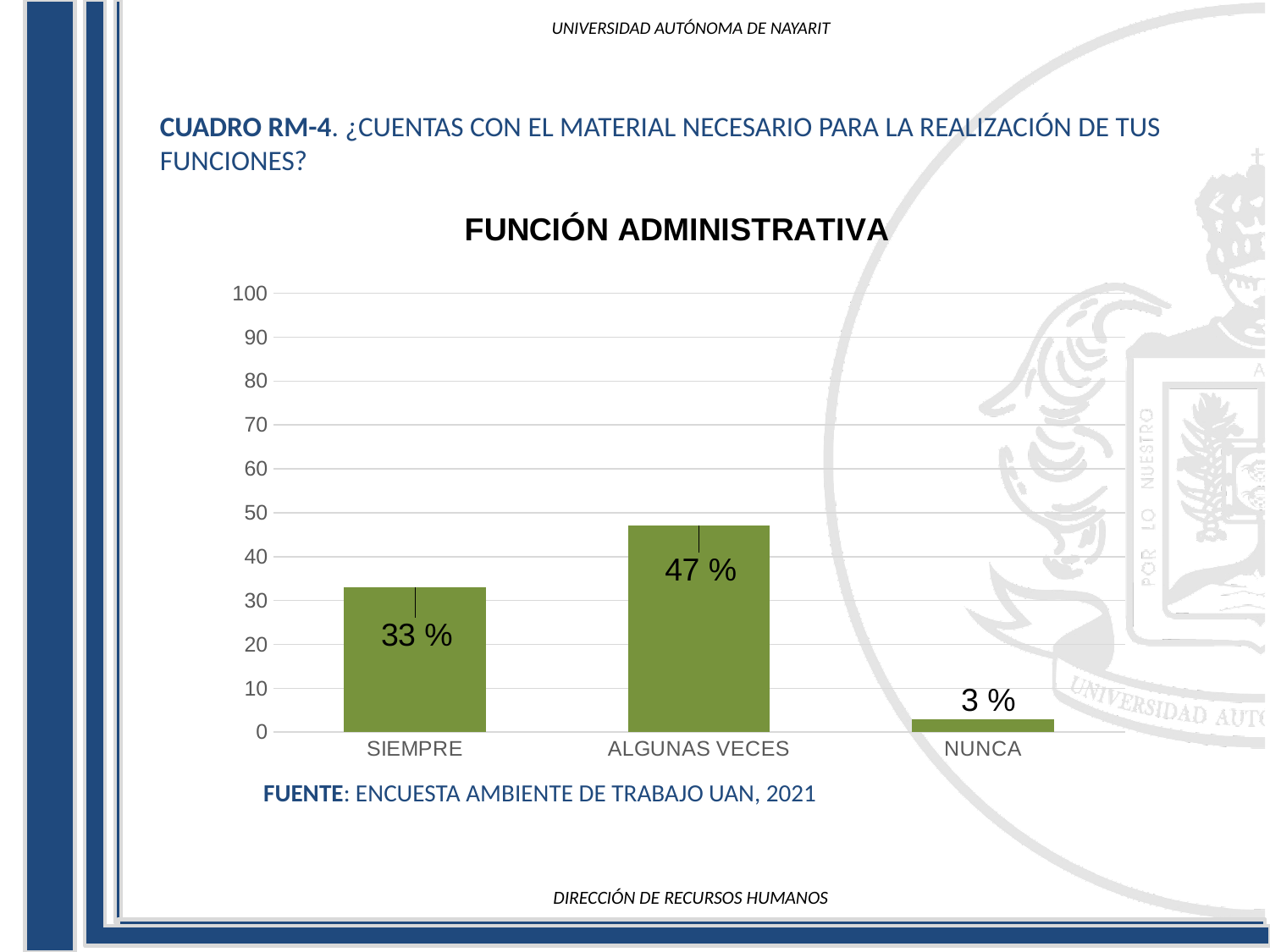
What is the value for NUNCA? 3 % Is the value for ALGUNAS VECES greater or less than 40? greater Which category has the highest value? ALGUNAS VECES Which is larger, the value for SIEMPRE or the value for NUNCA? SIEMPRE What is the value for SIEMPRE? 33 % What is the difference between the values for ALGUNAS VECES and SIEMPRE? 14 % What is the value for ALGUNAS VECES? 47 % Which category has the lowest value? NUNCA What is the difference between the values for SIEMPRE and NUNCA? 30 % How many categories are shown on the x axis? 3 What kind of chart is shown on the slide? bar chart What is the title of the chart? FUNCIÓN ADMINISTRATIVA